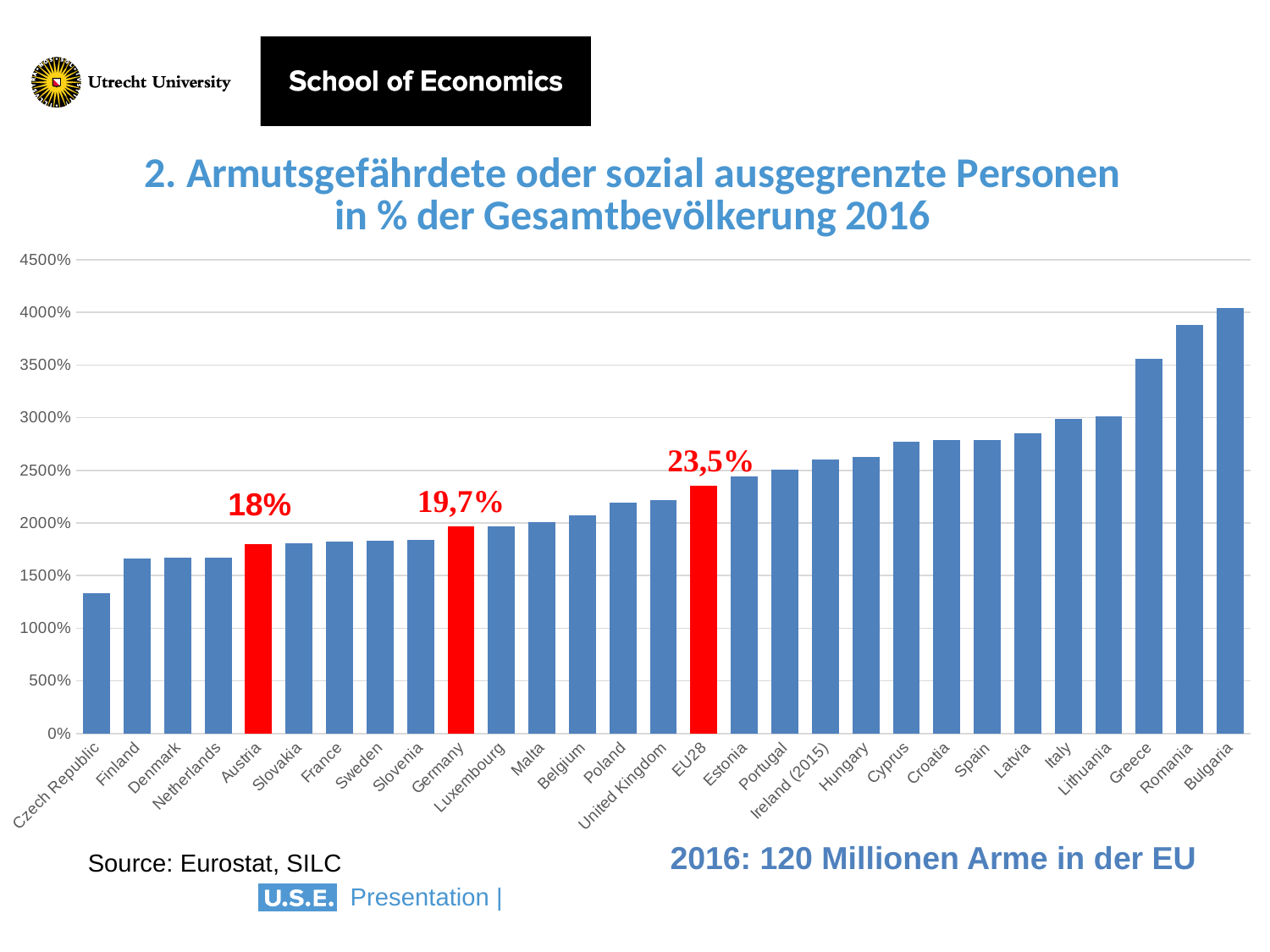
Which country has the lowest bar in the chart? Czech Republic How many countries/categories are shown on the x axis? 29 Which country has the highest bar in the chart? Bulgaria What is the difference between the labelled values for Germany and Austria? 1,7 percentage points Do the bars generally rise or fall from left to right along the x axis? Rise What is the difference between the labelled values for EU28 and Austria? 5,5 percentage points What is the value shown for Austria? 18% What is the value shown for EU28? 23,5% What is the value shown for Germany? 19,7% What type of chart is shown on the slide? Bar chart Which has the larger value, Germany or Austria? Germany Is the value for Romania greater or less than 4000%? less